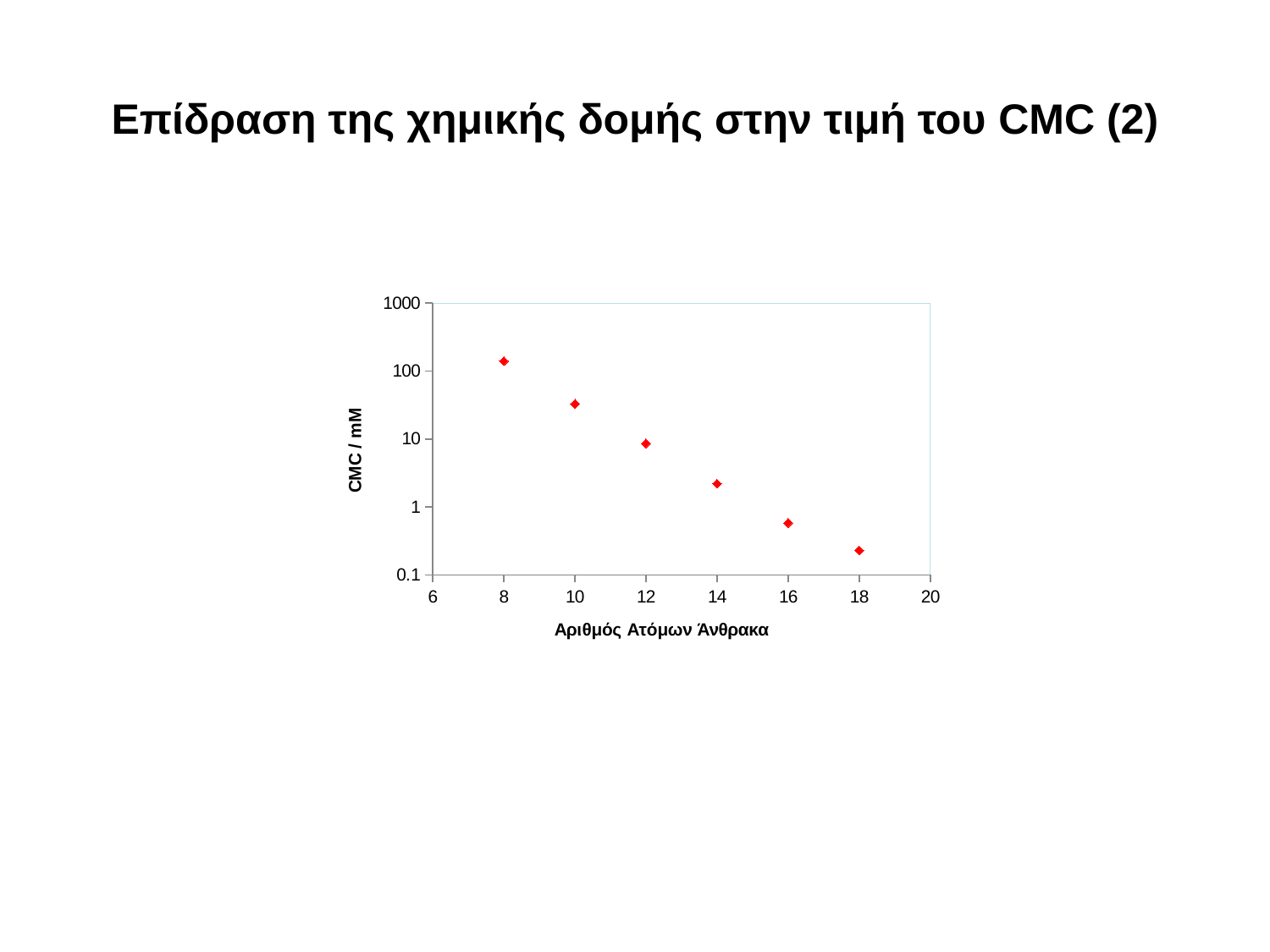
Is the CMC value for 10 carbon atoms greater or less than 10? greater Which has a larger CMC value: 10 carbon atoms or 14 carbon atoms? 10 carbon atoms At which number of carbon atoms is the CMC value highest? 8 What is the label of the x axis? Αριθμός Ατόμων Άνθρακα How many data points are plotted on the chart? 6 What kind of chart is shown on the slide? scatter plot Is the CMC value for 14 carbon atoms greater or less than 1? greater Do the CMC values rise or fall as the number of carbon atoms increases? fall Is the CMC value for 16 carbon atoms greater or less than 1? less What is the label of the y axis? CMC / mM At which number of carbon atoms is the CMC value lowest? 18